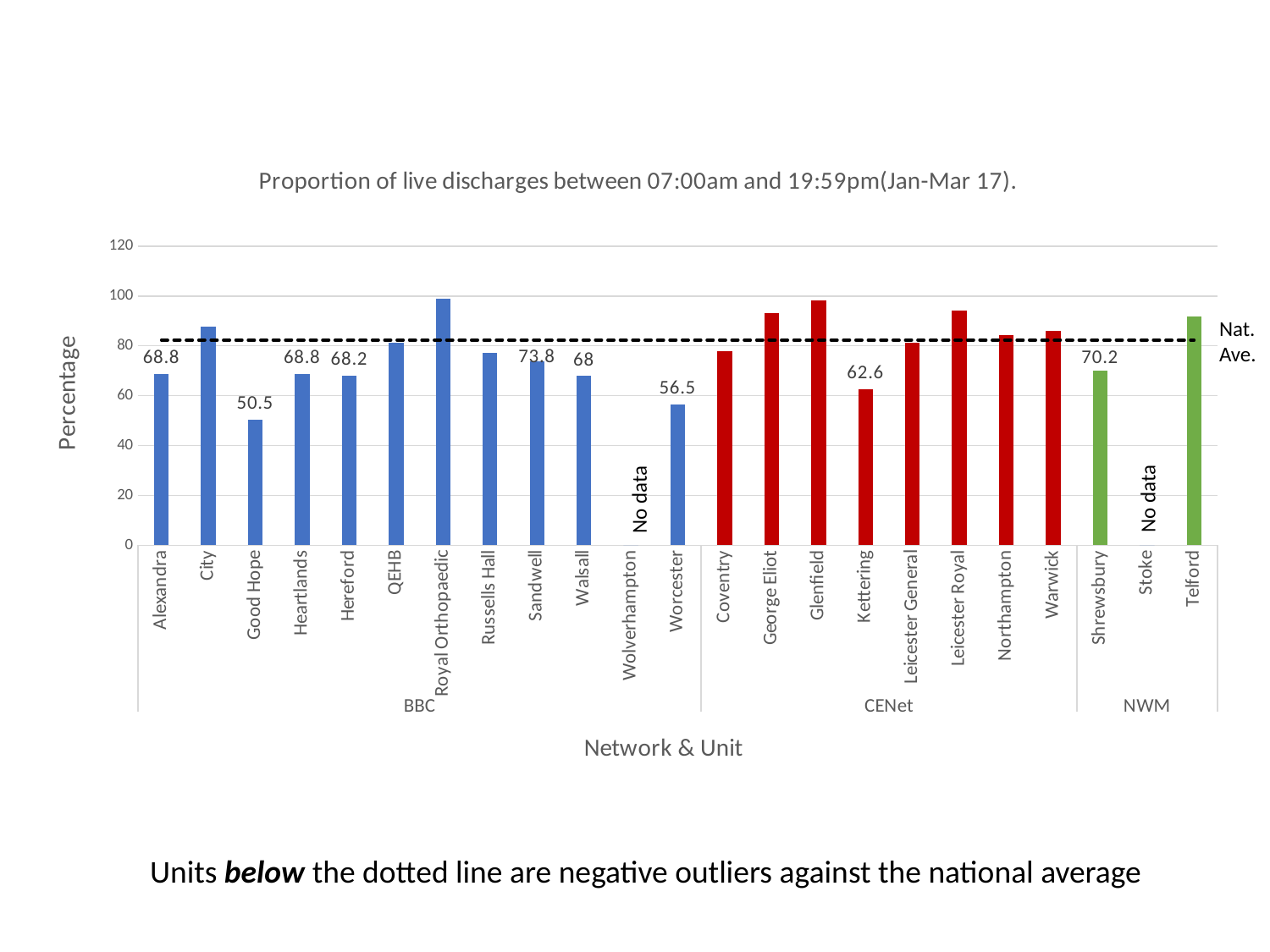
Which units are marked as having no data? Wolverhampton and Stoke What kind of chart is shown on the slide? Bar chart What is the value for Worcester? 56.5 What is the value for Good Hope? 50.5 Is the value for City greater or less than 80? greater Which has the larger value, Alexandra or Hereford? Alexandra How many networks are shown along the x axis? 3 Is the value for Glenfield greater or less than 80? greater What is the value for Kettering? 62.6 What is the value for Shrewsbury? 70.2 What is the difference between the values for Sandwell and Walsall? 5.8 Which unit has the lowest value on the chart? Good Hope